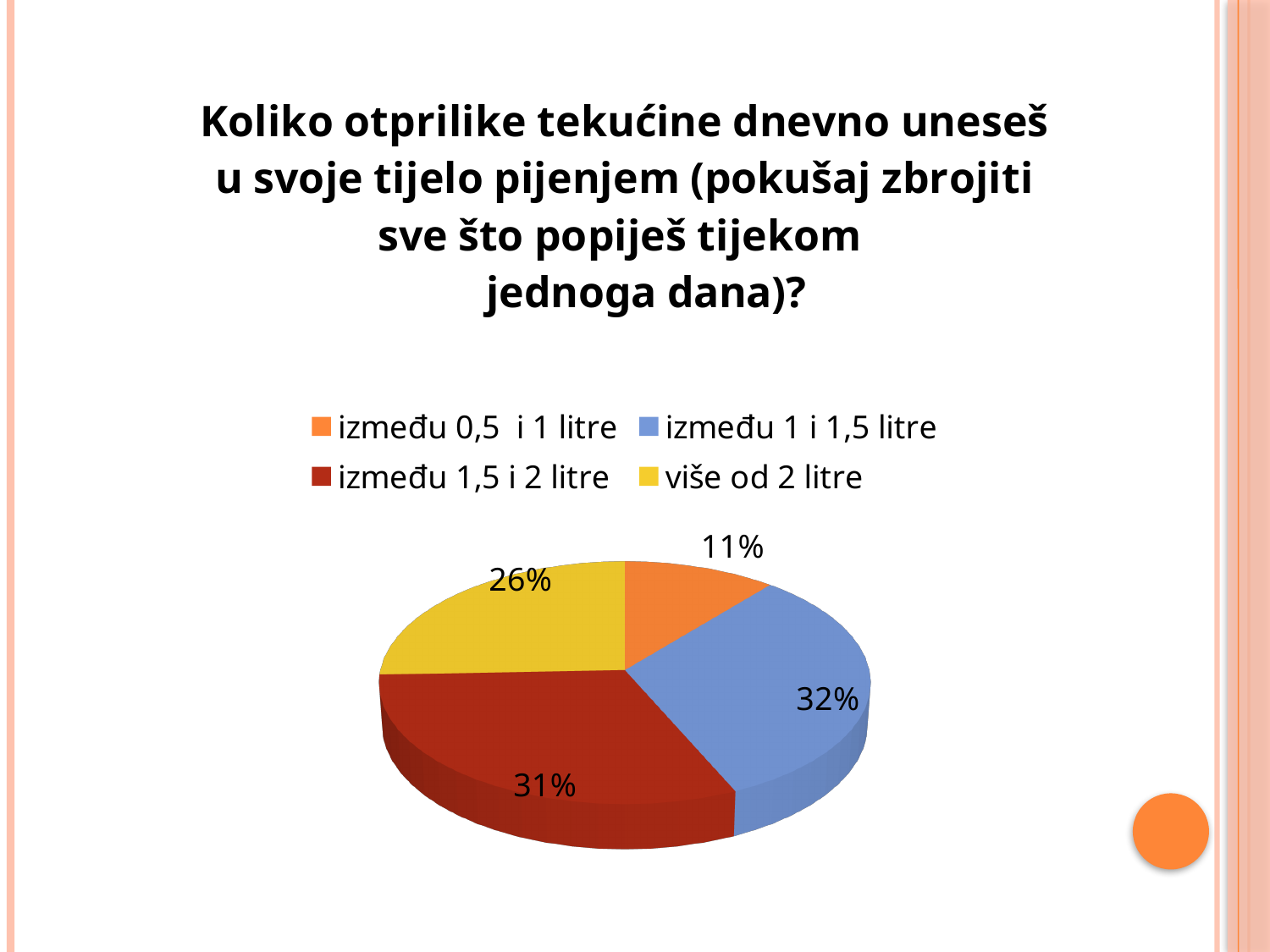
How many categories does the pie chart show? 4 What share of the pie does the 'između 0,5 i 1 litre' slice represent? 11% What colour is the 'između 1,5 i 2 litre' slice? Dark red What share of the pie does the 'više od 2 litre' slice represent? 26% Which category has the smallest share of the pie? između 0,5 i 1 litre What is the difference in percentage points between the 'više od 2 litre' slice and the 'između 0,5 i 1 litre' slice? 15% What colour is the 'više od 2 litre' slice? Yellow Which is larger: the share for 'više od 2 litre' or the share for 'između 0,5 i 1 litre'? više od 2 litre What share of the pie does the 'između 1 i 1,5 litre' slice represent? 32% What kind of chart is shown on the slide? Pie chart Which category has the largest share of the pie? između 1 i 1,5 litre